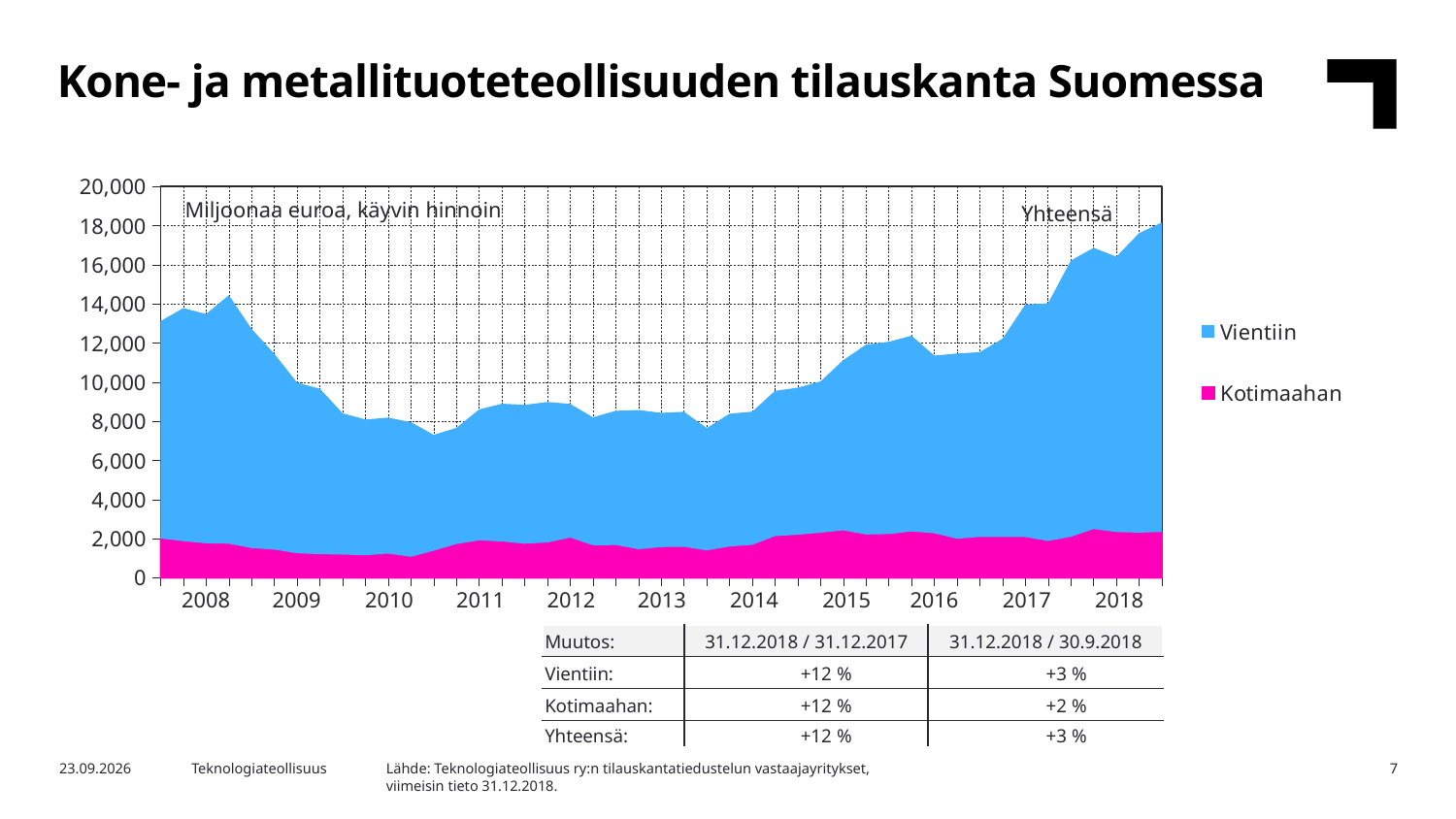
What kind of chart is shown on the slide? Stacked area chart How many series does the chart legend list? 2 Is the total (Yhteensä) order book at the end of 2018 greater or less than 16,000? greater How many year labels are shown on the x axis? 11 Does the total order book rise or fall between 2014 and 2018? rise What unit is stated in the text inside the chart area? Miljoonaa euroa, käyvin hinnoin Is the total (Yhteensä) order book at the start of 2008 greater or less than 12,000? greater Is the total (Yhteensä) order book in 2013 greater or less than 10,000? less Which two series are listed in the chart legend? Vientiin and Kotimaahan Which series is larger throughout the chart, Vientiin or Kotimaahan? Vientiin Does the total order book rise or fall between 2008 and 2010? fall